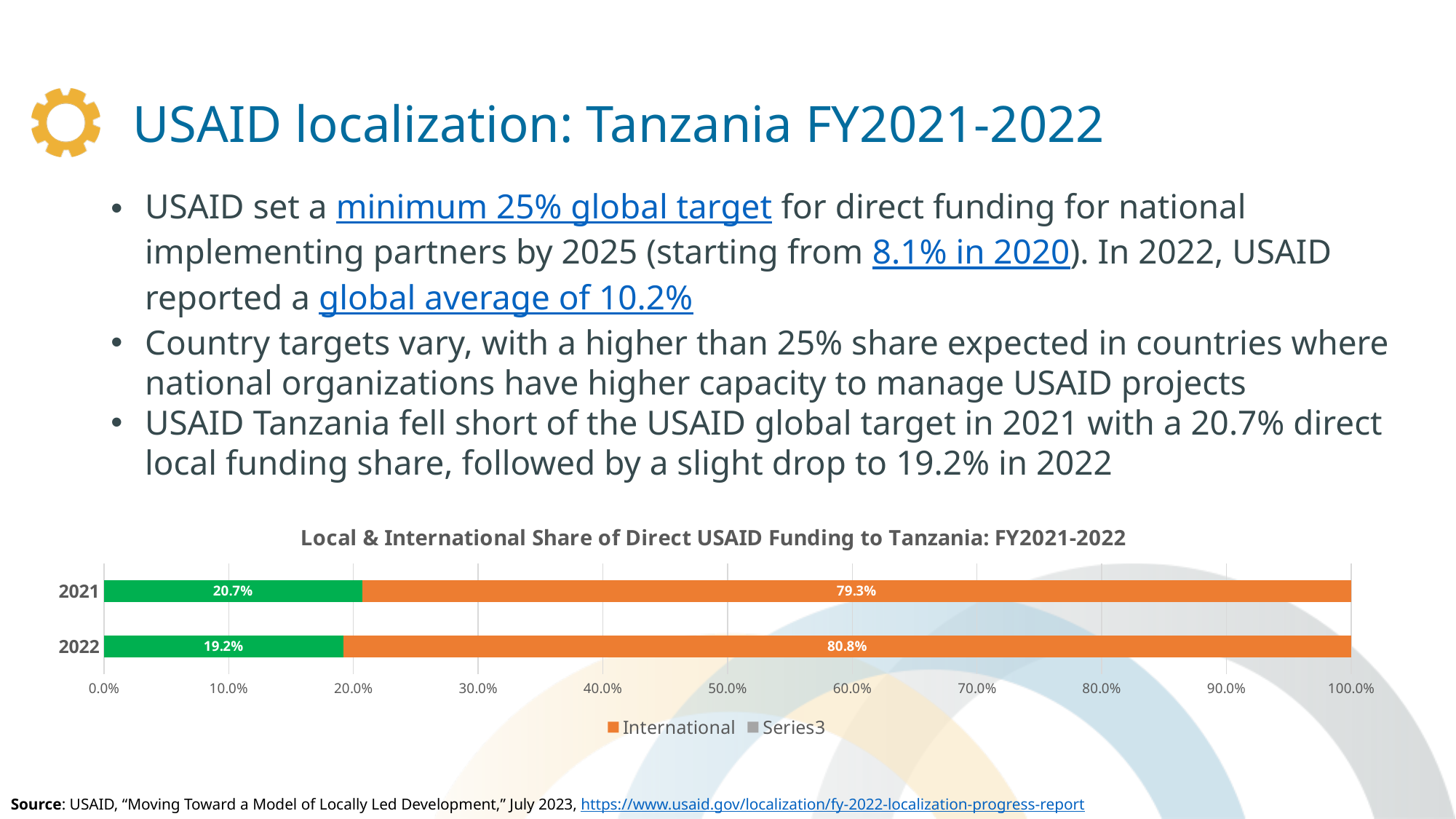
What is the total of the two labelled segments in the 2021 bar? 100.0% What is the International share of direct USAID funding to Tanzania in 2022? 80.8% Which year has the larger International share, 2021 or 2022? 2022 How many series does the chart legend list? 2 What is the title of the chart? Local & International Share of Direct USAID Funding to Tanzania: FY2021-2022 What is the International share of direct USAID funding to Tanzania in 2021? 79.3% How many years (categories) are plotted in the chart? 2 Does the green (local) segment rise or fall from 2021 to 2022? Fall What value is printed on the green segment of the 2021 bar? 20.7% What type of chart is shown on the slide? Stacked bar chart By how many percentage points does the International share in 2022 exceed that in 2021? 1.5 percentage points What value is printed on the green segment of the 2022 bar? 19.2%